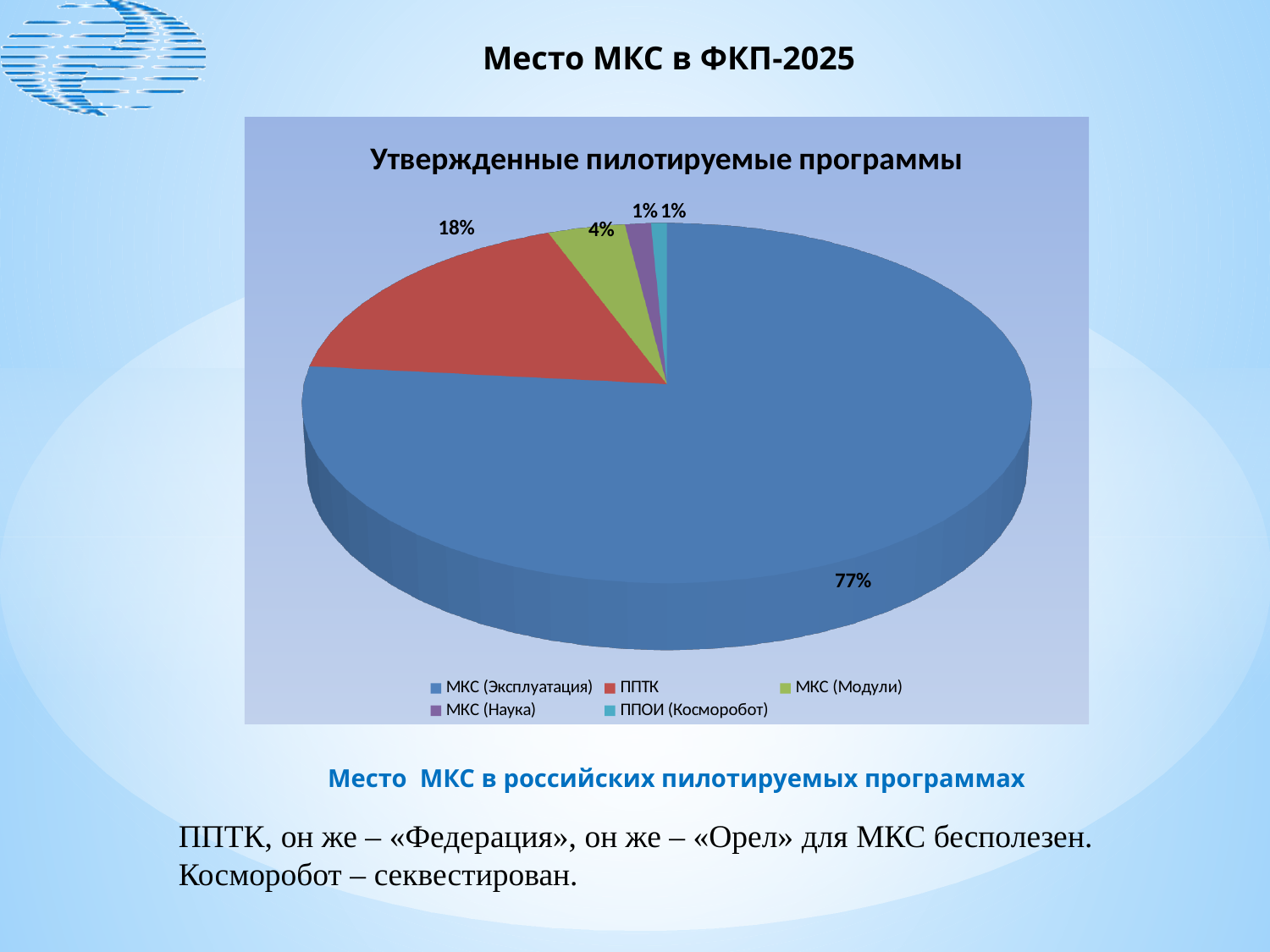
What type of chart is shown on the slide? Pie chart What colour is the ППТК slice? Red What is the title of the chart? Утвержденные пилотируемые программы Which slice is larger, ППТК or МКС (Модули)? ППТК What is the difference in percentage points between the МКС (Эксплуатация) slice and the ППТК slice? 59 What share of the pie does МКС (Модули) have? 4% What share of the pie does МКС (Эксплуатация) have? 77% How many categories does the legend list? 5 What share of the pie does ППТК have? 18% Which category has the largest slice of the pie? МКС (Эксплуатация)